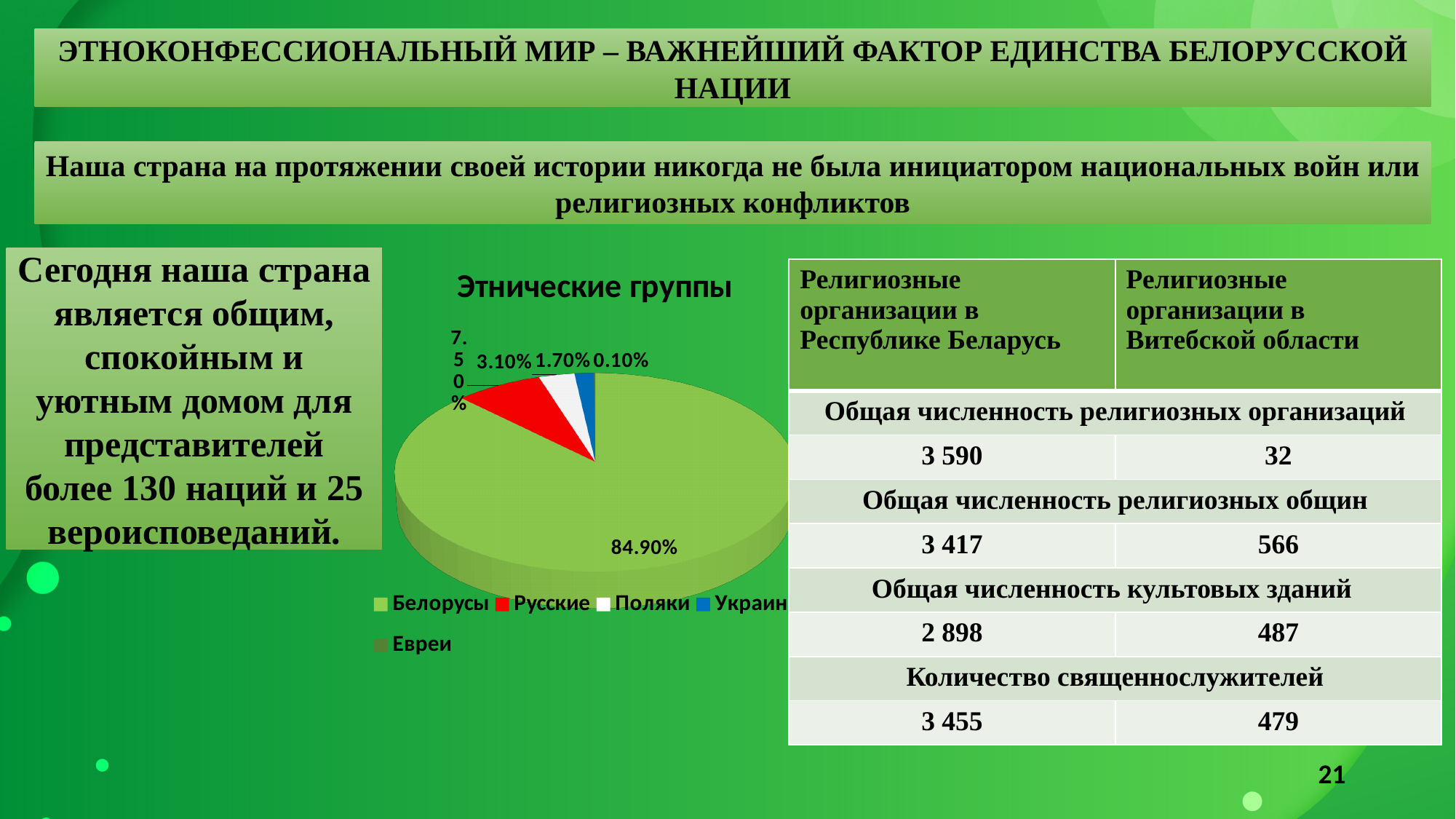
Which ethnic group has the largest slice in the "Этнические группы" pie chart? Белорусы In the "Этнические группы" pie chart, what is the difference between the shares of Поляки and Евреи? 3.00% What kind of chart is the "Этнические группы" chart? pie chart What is the title of the pie chart on the slide? Этнические группы How many ethnic groups are listed in the legend of the "Этнические группы" pie chart? 5 In the "Этнические группы" pie chart, what share is shown for Евреи? 0.10% What colour is the Русские slice in the "Этнические группы" pie chart? red In the "Этнические группы" pie chart, which slice is larger: Русские or Поляки? Русские In the "Этнические группы" pie chart, what share is shown for Белорусы? 84.90% In the "Этнические группы" pie chart, what share is shown for Русские? 7.50% Which ethnic group has the smallest slice in the "Этнические группы" pie chart? Евреи In the "Этнические группы" pie chart, what share is shown for Поляки? 3.10%